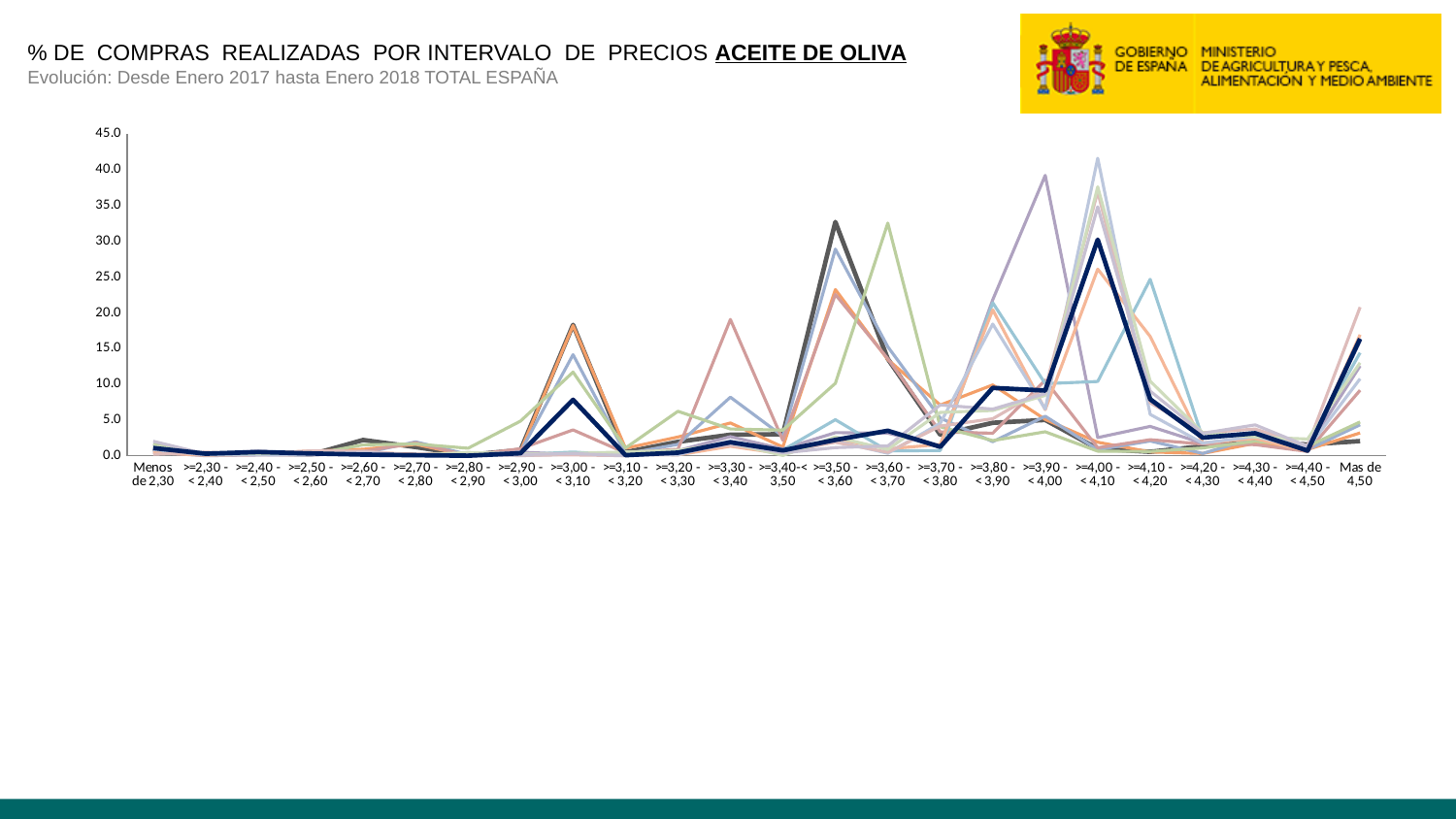
What is the highest value shown on the y axis? 45.0 Is the value of the thick dark blue line for the interval >=4,00 - < 4,10 greater or less than 25.0? greater In which price interval does the thick dark blue line reach its highest value? >=4,00 - < 4,10 Does the thick dark blue line rise or fall between the intervals >=4,00 - < 4,10 and >=4,10 - < 4,20? fall What product does the chart title say the purchase percentages refer to? ACEITE DE OLIVA For the thick dark blue line, which value is larger: the one at >=4,00 - < 4,10 or the one at Mas de 4,50? >=4,00 - < 4,10 What kind of chart is shown on the slide? line chart Is the value of the thick dark blue line for the interval >=3,00 - < 3,10 greater or less than 10.0? less Is the value of the thick dark blue line for the interval Mas de 4,50 greater or less than 10.0? greater How many price intervals (categories) are shown along the x axis? 24